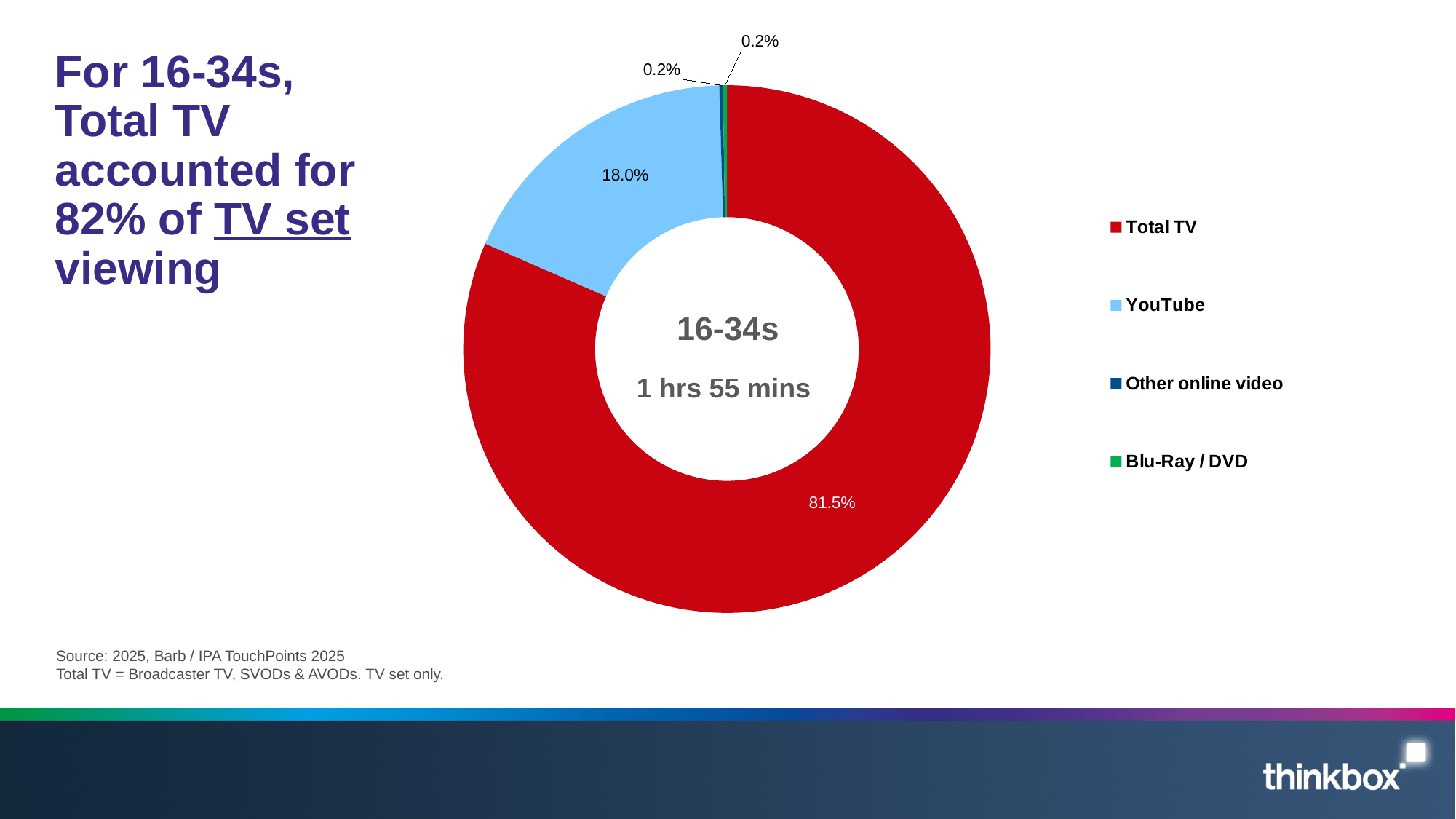
What share of TV set viewing does Total TV account for in the doughnut chart? 81.5% Which colour represents YouTube in the chart? Light blue How many categories does the legend list? 4 What text is shown in the centre of the doughnut chart? 16-34s, 1 hrs 55 mins What kind of chart is shown on the slide? Doughnut (pie) chart What share of TV set viewing does YouTube account for? 18.0% Which category has the larger share, YouTube or Total TV? Total TV Is the share for YouTube greater or less than 20%? less What share is shown for Blu-Ray / DVD? 0.2% What is the difference in percentage points between the Total TV share and the YouTube share? 63.5 Which category has the largest share of the doughnut chart? Total TV What is the combined share of Other online video and Blu-Ray / DVD? 0.4%